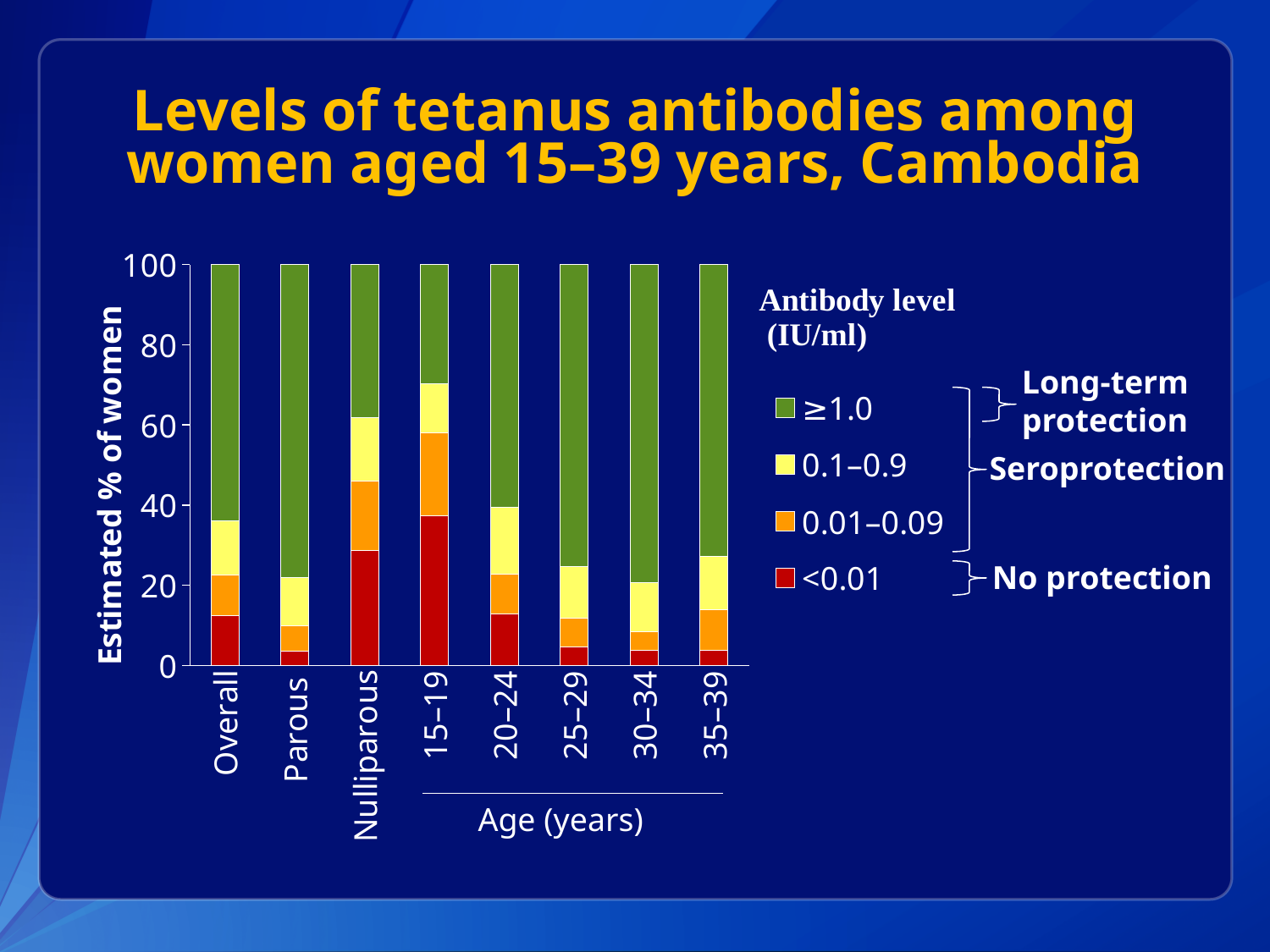
What is the label on the y axis of the chart? Estimated % of women What is the total height of the stacked bar for Overall? 100 How many antibody level series does the legend list? 4 Is the <0.01 segment for the Parous group greater or less than 20? less How many categories are shown along the x axis of the chart? 8 Which has a larger <0.01 segment, the 15–19 group or the 35–39 group? 15–19 Which category has the smallest ≥1.0 (long-term protection) segment? 15–19 What kind of chart is shown on the slide? Stacked bar chart Which category has the largest <0.01 (no protection) segment? 15–19 Is the <0.01 segment for the 15–19 age group greater or less than 20? greater Is the ≥1.0 segment for the Nulliparous group greater or less than 60? less Which has a larger ≥1.0 segment, the Parous group or the Nulliparous group? Parous